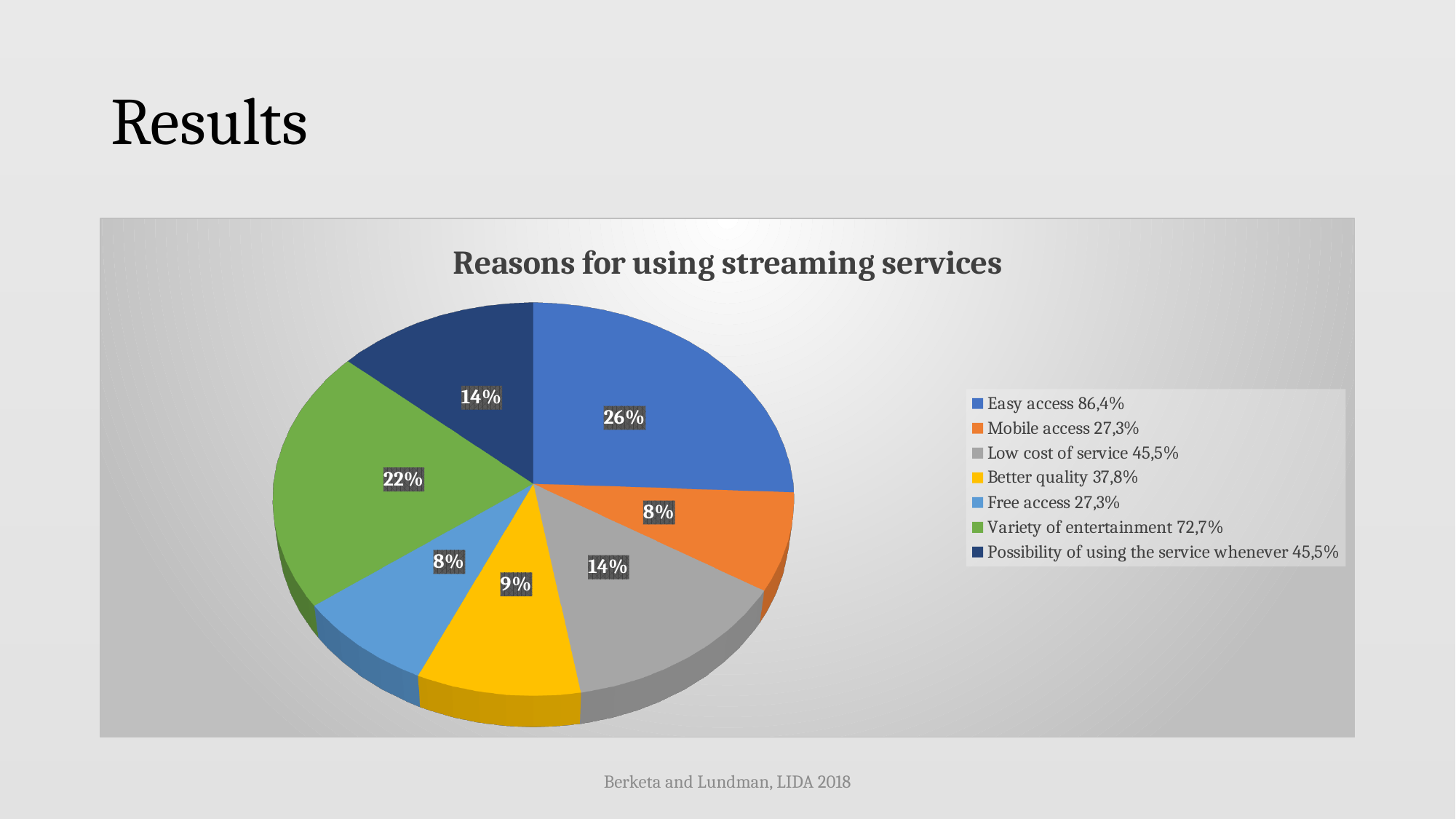
What share of the pie does the Easy access slice represent? 26% What percentage is shown in the legend for Low cost of service? 45,5% What is the title of the chart? Reasons for using streaming services What percentage is shown in the legend for Possibility of using the service whenever? 45,5% What percentage is shown in the legend for Variety of entertainment? 72,7% How many slices does the pie chart have? 7 What is the difference between the pie share of Easy access and the pie share of Variety of entertainment? 4% Which reason has the largest slice of the pie? Easy access What share of the pie does the Variety of entertainment slice represent? 22% What share of the pie does the Better quality slice represent? 9% What kind of chart is shown on the slide? pie chart Which is larger, the slice for Low cost of service or the slice for Mobile access? Low cost of service